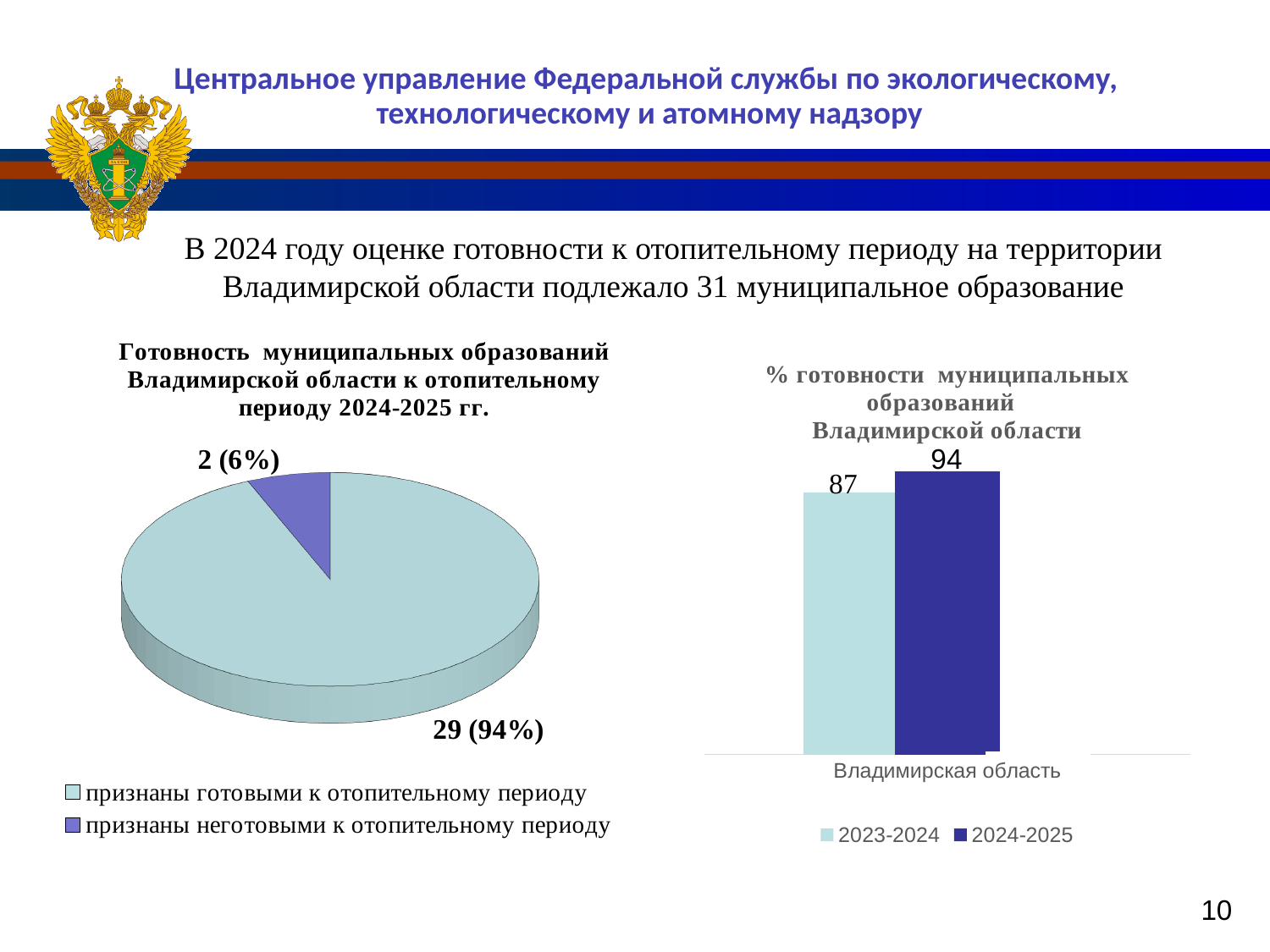
On the pie chart on the left, what value is shown for municipalities recognised as not ready (признаны неготовыми к отопительному периоду)? 2 (6%) On the pie chart on the left, what share of the pie do the municipalities recognised as ready represent? 94% What type of chart is the chart on the right of the slide? bar chart On the pie chart on the left, how many slices does the pie have? 2 What type of chart is the chart on the left of the slide? pie chart On the pie chart on the left, how many municipalities were recognised as ready for the heating period (признаны готовыми к отопительному периоду)? 29 (94%) On the pie chart on the left, which category is the largest? признаны готовыми к отопительному периоду On the bar chart on the right, how many series does the legend list? 2 On the bar chart on the right, what is the difference between the 2024-2025 and 2023-2024 values? 7 On the bar chart on the right, what is the value for 2023-2024 for Владимирская область? 87 On the bar chart on the right, what is the value for 2024-2025 for Владимирская область? 94 On the bar chart on the right, which series has the larger value: 2023-2024 or 2024-2025? 2024-2025